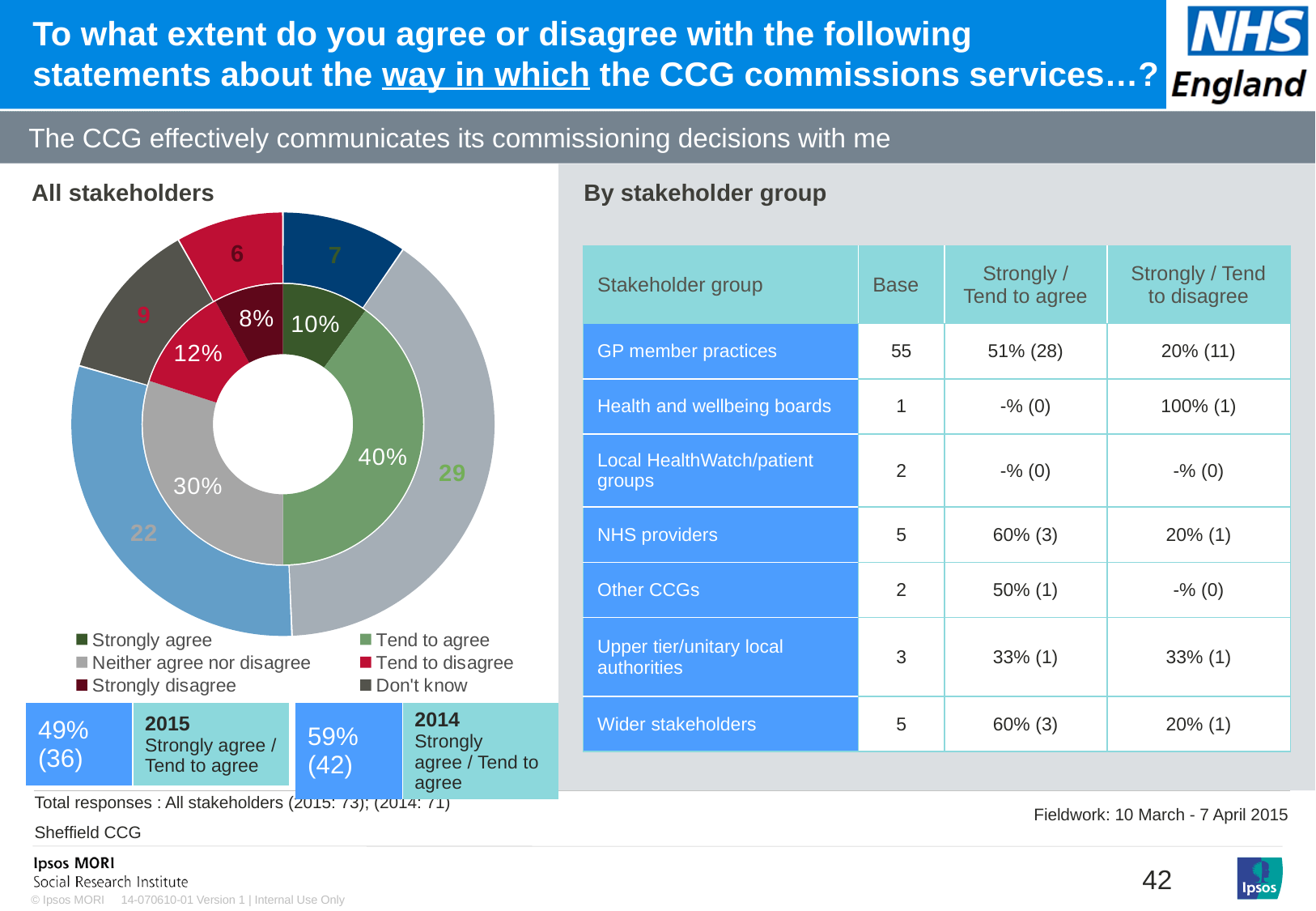
In the 'All stakeholders' chart, which response category has the largest share? Tend to agree In the 'All stakeholders' chart, what colour represents 'Neither agree nor disagree' in the legend? Grey In the 'All stakeholders' chart, what percentage of respondents 'Tend to agree'? 40% In the 'All stakeholders' chart, which labelled response category has the smallest percentage share? Strongly disagree In the 'All stakeholders' chart, what percentage of respondents 'Strongly agree'? 10% In the 'All stakeholders' chart, what percentage of respondents 'Strongly disagree'? 8% In the 'All stakeholders' chart, what percentage of respondents 'Tend to disagree'? 12% In the 'All stakeholders' chart, what percentage of respondents 'Neither agree nor disagree'? 30% What kind of chart is shown under 'All stakeholders'? Doughnut chart How many response categories does the legend of the 'All stakeholders' chart list? 6 In the 'All stakeholders' chart, which is larger: the share for 'Tend to disagree' or the share for 'Strongly agree'? Tend to disagree In the 'All stakeholders' chart, what is the difference in percentage points between 'Tend to agree' and 'Neither agree nor disagree'? 10 percentage points